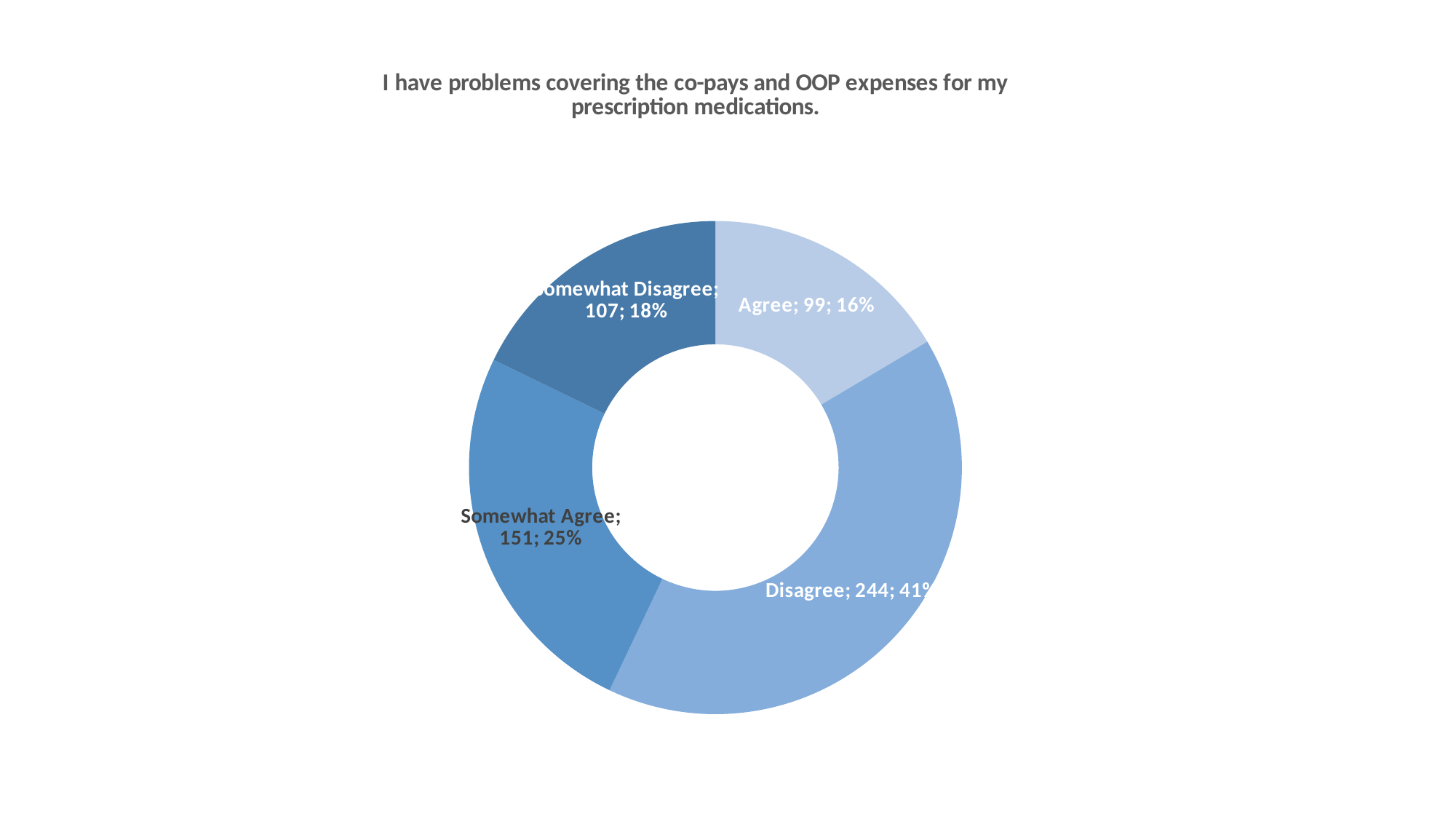
What kind of chart is shown on the slide? Doughnut (pie) chart Which has more respondents, Somewhat Disagree or Agree? Somewhat Disagree What percentage of respondents chose Somewhat Agree? 25% How many response categories are shown in the chart? 4 Which response category has the smallest slice? Agree Which response category has the largest slice? Disagree What is the total number of respondents across all four categories? 601 What percentage share does the Somewhat Disagree slice have? 18% How many respondents chose Disagree? 244 What is the title of the chart? I have problems covering the co-pays and OOP expenses for my prescription medications. What is the difference in count between Disagree and Somewhat Agree? 93 How many respondents chose Agree? 99